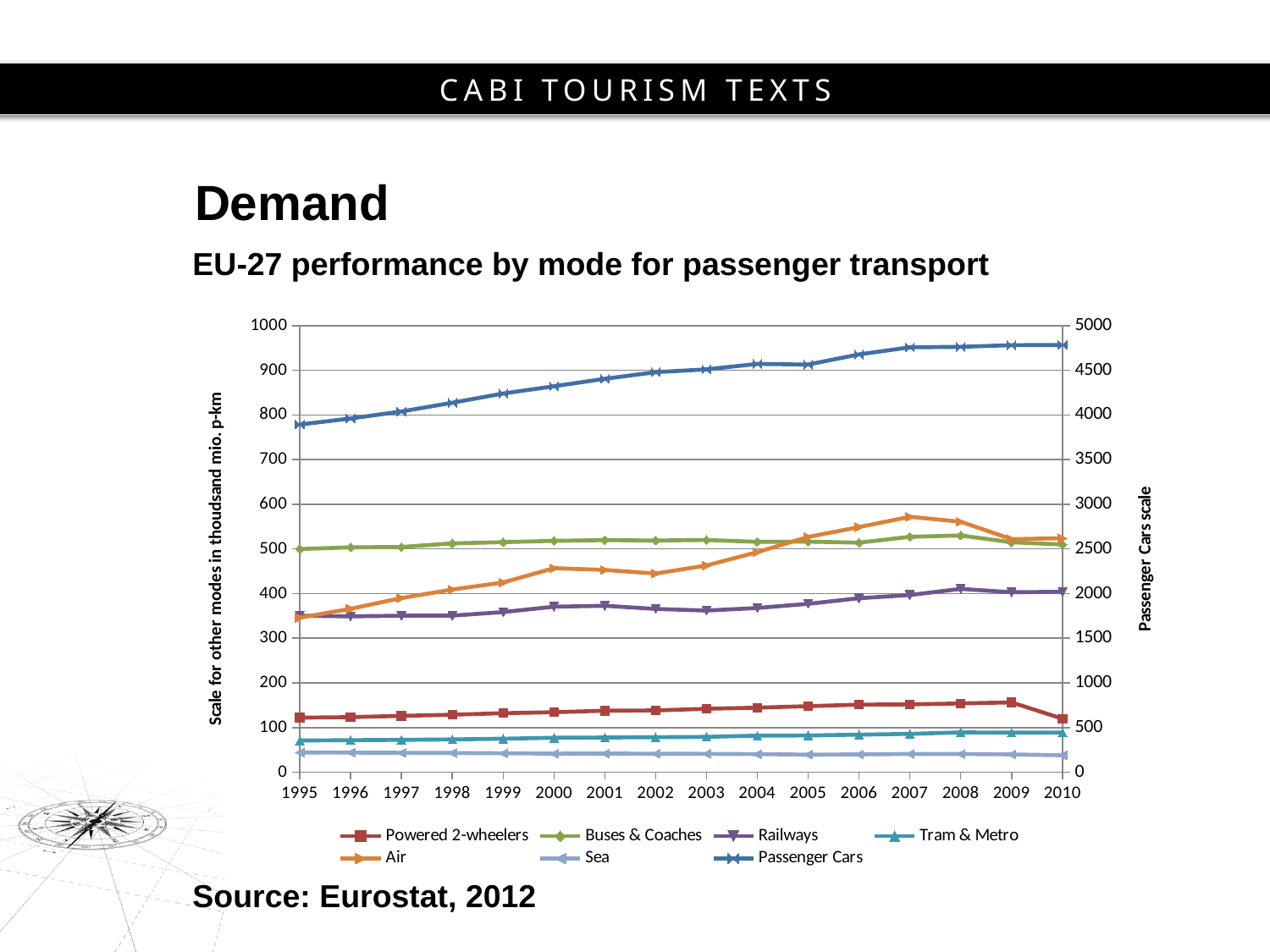
Which series is plotted highest on the chart across all years? Passenger Cars In 1995, which is larger: Air or Buses & Coaches? Buses & Coaches How many series does the legend list? 7 Is the value for Powered 2-wheelers in 2009 greater or less than 100? greater Does the Passenger Cars line rise or fall from 1995 to 2010? rise Is the value for Passenger Cars in 2010 on the right-hand scale greater or less than 4500? greater Is the value for Air in 1995 greater or less than 400? less How many years are plotted along the x axis? 16 What is the label of the right-hand vertical axis? Passenger Cars scale Which series is plotted lowest on the chart across all years? Sea In 2007, which is larger: Air or Buses & Coaches? Air What kind of chart is shown on the slide? line chart